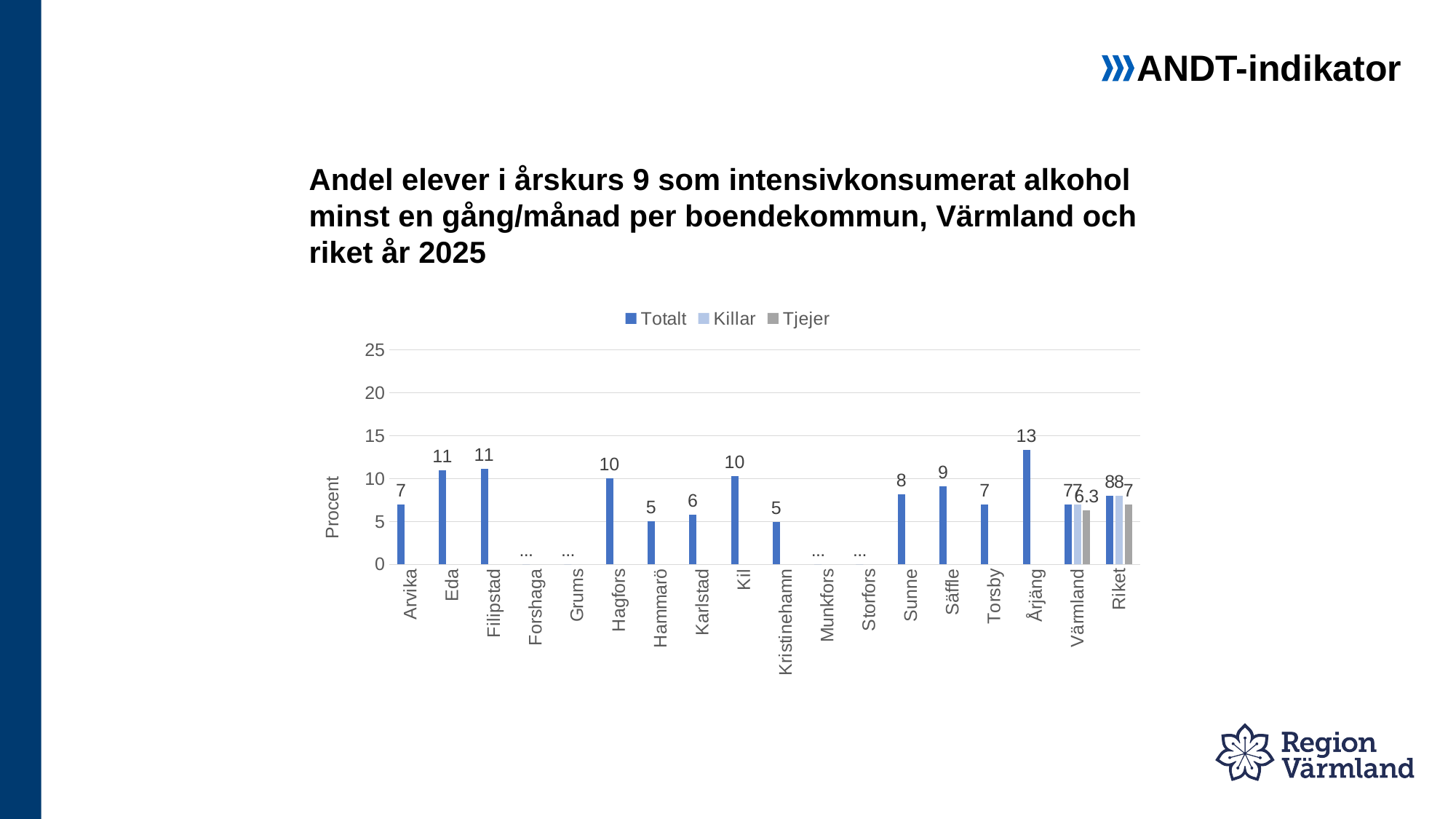
Which has a higher Totalt value, Hagfors or Sunne? Hagfors What is the difference between the Totalt values for Årjäng and Arvika? 6 What is the label on the y axis? Procent Which municipality has the highest Totalt value? Årjäng Is the Totalt value for Årjäng greater or less than 10? greater What is the Totalt value for Årjäng? 13 What kind of chart is shown on the slide? bar chart How many categories are shown on the x axis? 18 What is the Tjejer value for Värmland? 6.3 How many series does the legend list? 3 What is the Killar value for Riket? 8 What is the Totalt value for Hammarö? 5